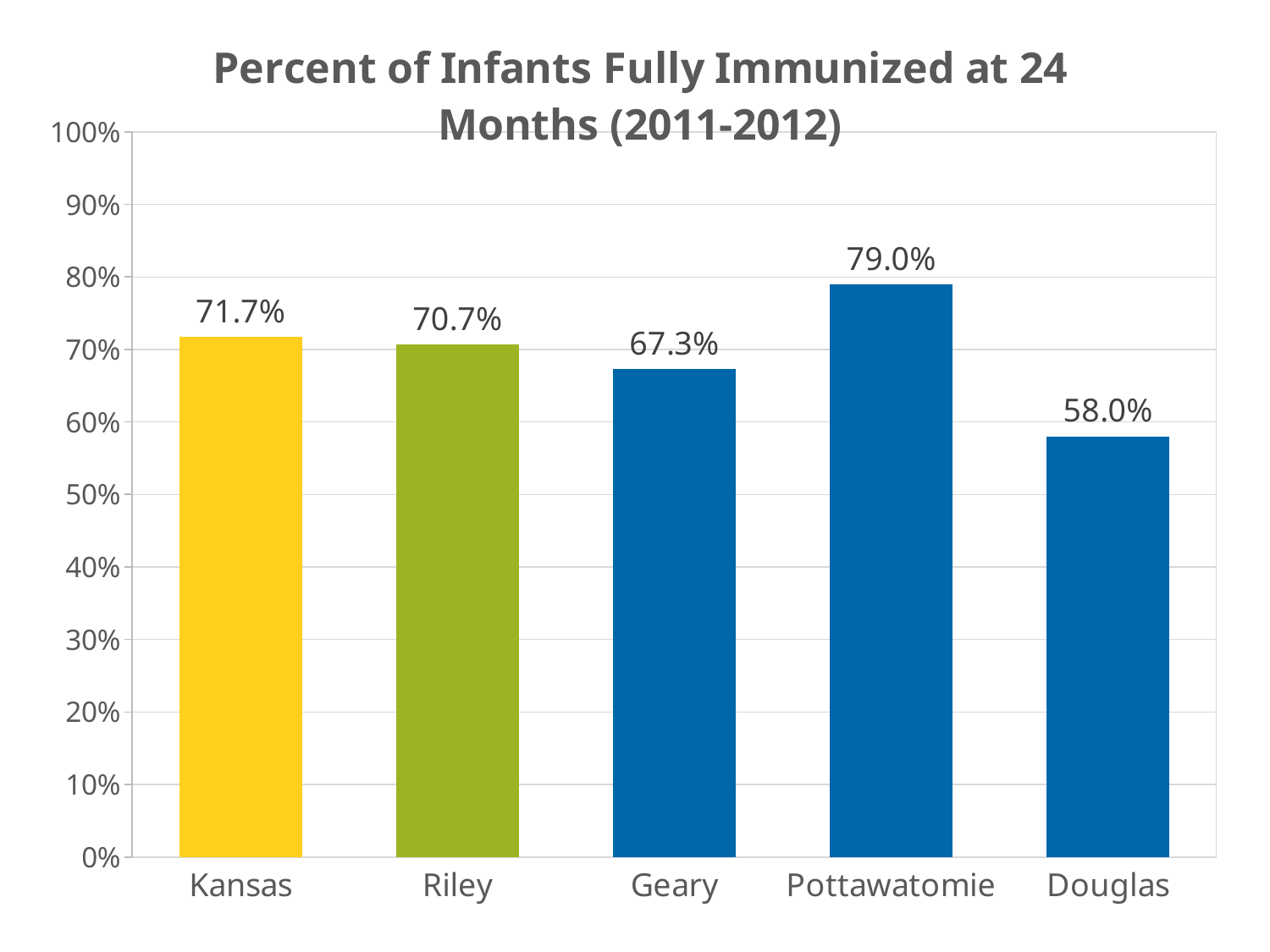
What is the title of the chart? Percent of Infants Fully Immunized at 24 Months (2011-2012) Which is larger, the value for Geary or the value for Douglas? Geary Which category has the lowest value? Douglas What is the difference between the values for Kansas and Geary? 4.4% What is the value for Kansas? 71.7% Which category has the highest value? Pottawatomie What is the difference between the values for Pottawatomie and Douglas? 21.0% How many categories are shown on the x axis? 5 Is the value for Riley greater or less than 60%? greater What is the value for Pottawatomie? 79.0% What is the value for Douglas? 58.0% What kind of chart is shown on the slide? bar chart